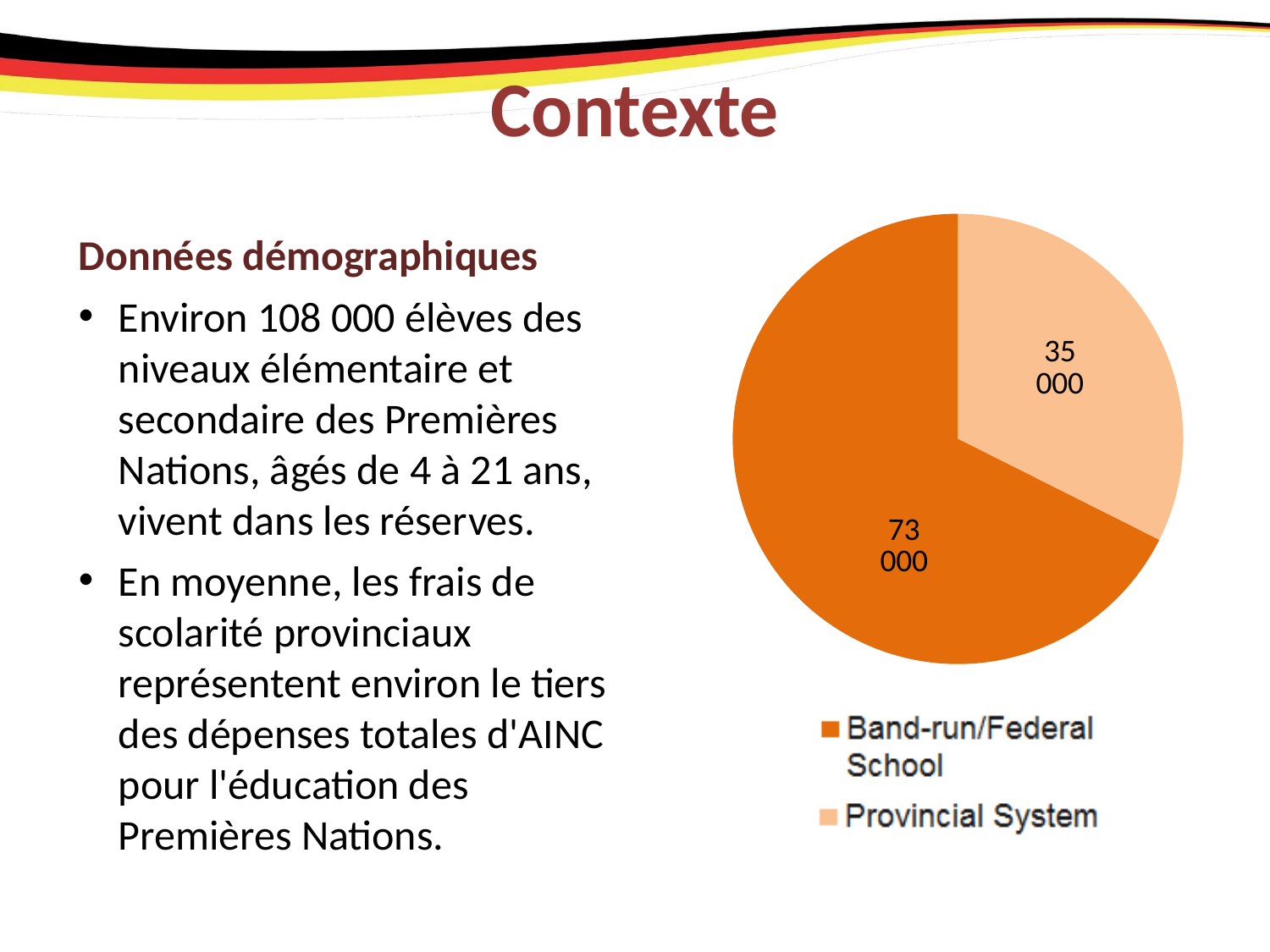
Which slice of the pie chart is the largest? Band-run/Federal School What kind of chart is shown on the slide? pie chart What is the value for Band-run/Federal School in the pie chart? 73 000 How many entries does the legend of the pie chart list? 2 What is the total of the two slices in the pie chart? 108 000 How many slices does the pie chart have? 2 What is the value for Provincial System in the pie chart? 35 000 What is the difference between the Band-run/Federal School value and the Provincial System value in the pie chart? 38 000 Which legend entry in the pie chart is shown in the lighter orange colour? Provincial System Which slice of the pie chart is the smallest? Provincial System What share of the pie chart does the Provincial System slice represent? 32.4% Which is larger in the pie chart, Band-run/Federal School or Provincial System? Band-run/Federal School